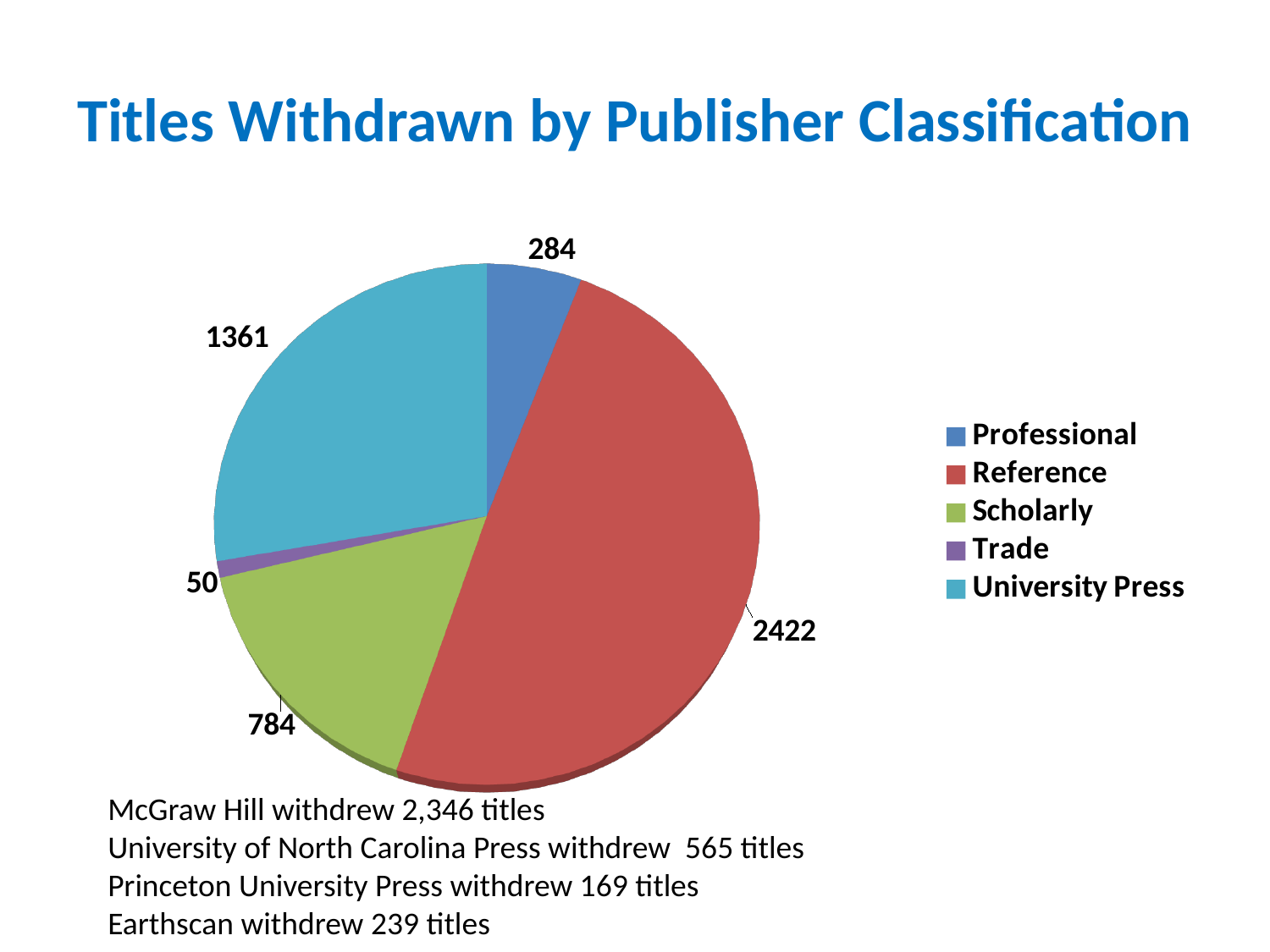
What is the value for Reference in the pie chart? 2422 What is the value for University Press in the pie chart? 1361 What is the difference between the Scholarly and Professional values? 500 Which is larger, the value for Scholarly or the value for University Press? University Press What is the value for Professional in the pie chart? 284 How many categories does the pie chart show? 5 Which publisher classification has the smallest number of titles withdrawn? Trade Which publisher classification has the largest number of titles withdrawn? Reference What is the difference between the Reference and University Press values? 1061 What is the title of the chart on the slide? Titles Withdrawn by Publisher Classification What is the value for Trade in the pie chart? 50 What kind of chart is shown on the slide? Pie chart